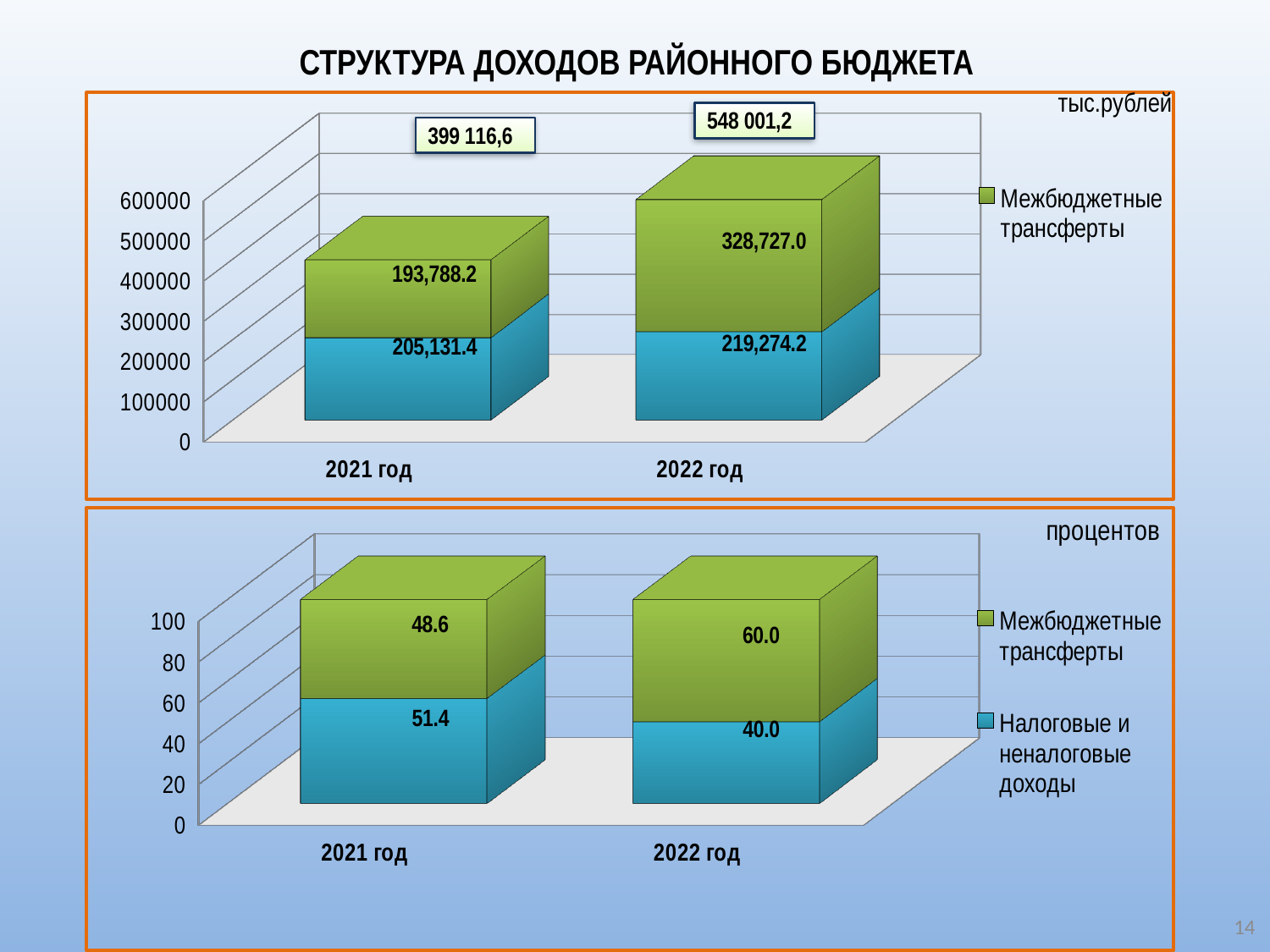
In the top chart (тыс.рублей), what is the total shown above the 2021 год bar? 399 116,6 How many categories (years) are shown on the x axis of the top chart (тыс.рублей)? 2 In the top chart (тыс.рублей), what is the difference between the Межбюджетные трансферты values for 2022 год and 2021 год? 134,938.8 In the top chart (тыс.рублей), what is the value of Межбюджетные трансферты for 2022 год? 328,727.0 In the top chart (тыс.рублей), what is the value of the blue (lower) segment for 2021 год? 205,131.4 In the bottom chart (процентов), what is the share of Налоговые и неналоговые доходы for 2022 год? 40.0 In the bottom chart (процентов), how many series does the legend list? 2 What kind of chart is the bottom chart (процентов)? Stacked bar chart In the top chart (тыс.рублей), which year has the larger Межбюджетные трансферты value? 2022 год In the bottom chart (процентов), which segment is larger for 2021 год: Межбюджетные трансферты or Налоговые и неналоговые доходы? Налоговые и неналоговые доходы In the top chart (тыс.рублей), what is the total shown above the 2022 год bar? 548 001,2 In the bottom chart (процентов), what is the value of Межбюджетные трансферты for 2021 год? 48.6